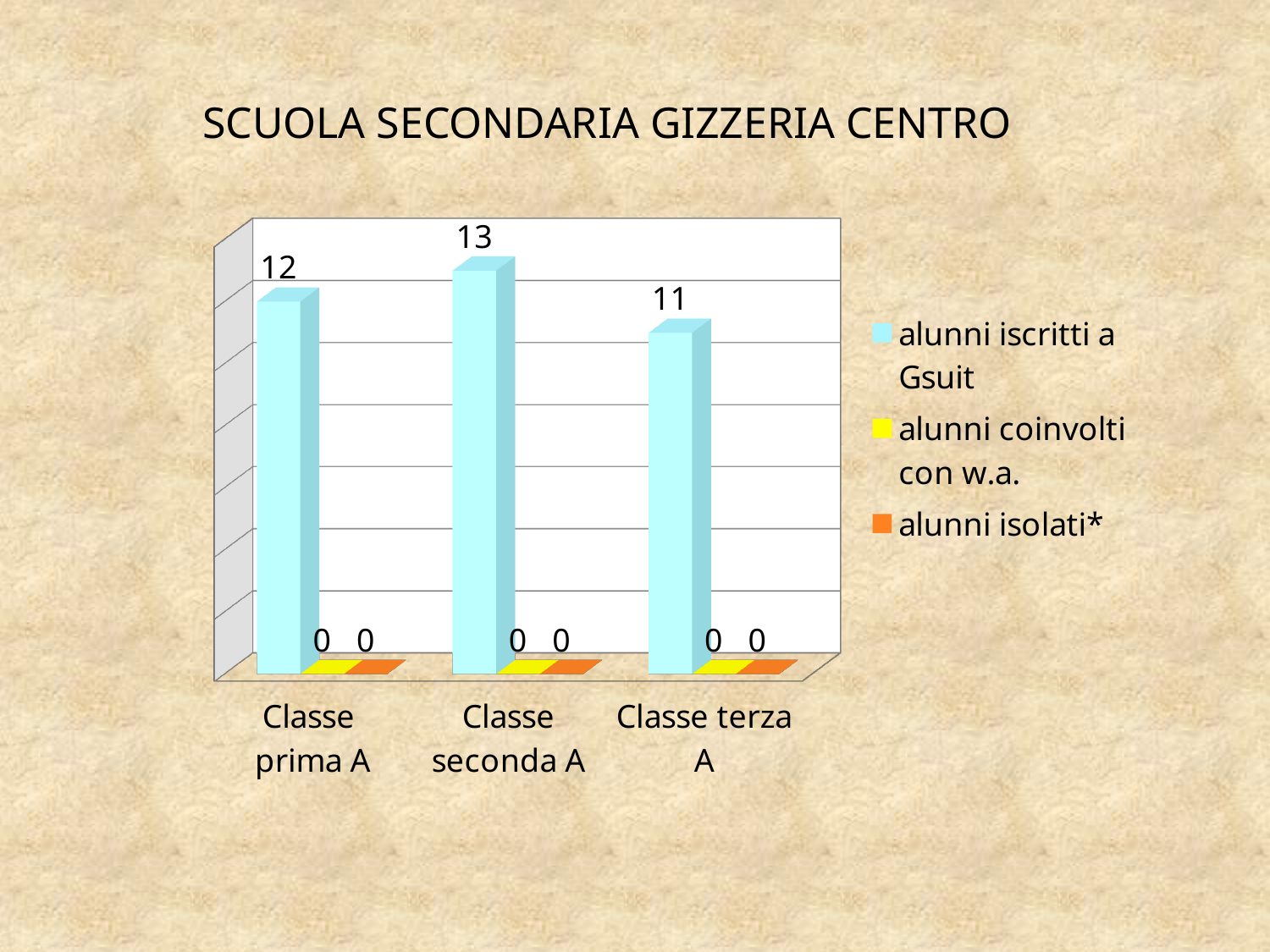
What is the value of 'alunni iscritti a Gsuit' for Classe prima A? 12 What is the difference between 'alunni iscritti a Gsuit' for Classe seconda A and Classe terza A? 2 How many classes are shown on the x axis? 3 What is the value of 'alunni iscritti a Gsuit' for Classe terza A? 11 What is the value of 'alunni coinvolti con w.a.' for Classe prima A? 0 Which class has the lowest value for 'alunni iscritti a Gsuit'? Classe terza A What kind of chart is shown on the slide? Bar chart Which is larger: 'alunni iscritti a Gsuit' for Classe prima A or for Classe terza A? Classe prima A What is the value of 'alunni isolati*' for Classe terza A? 0 Which class has the highest value for 'alunni iscritti a Gsuit'? Classe seconda A What is the value of 'alunni iscritti a Gsuit' for Classe seconda A? 13 How many series does the legend list? 3